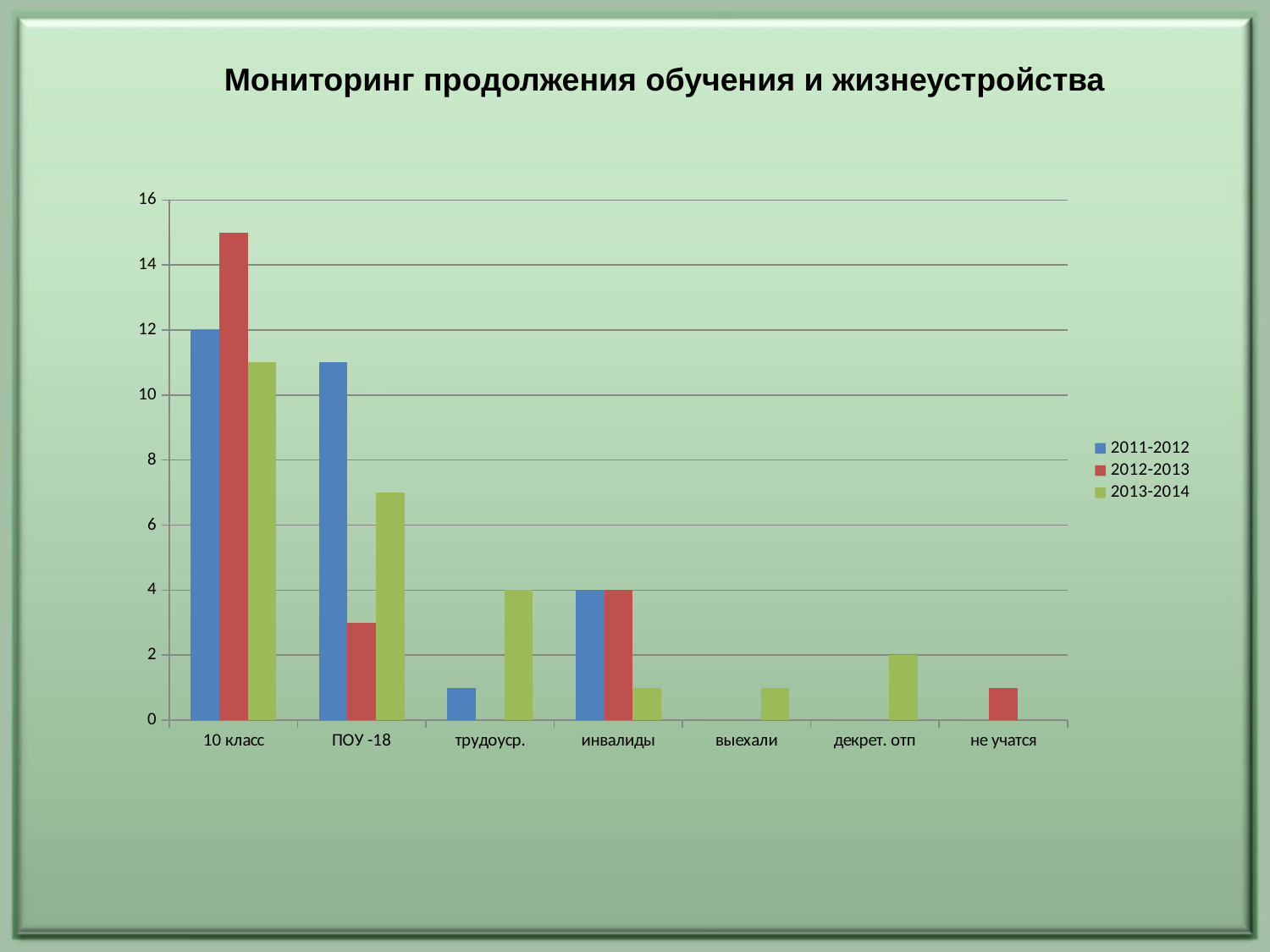
How many categories are shown on the x axis? 7 What is the value for 10 класс in the 2011-2012 series? 12 Which category has the highest value in the 2012-2013 series? 10 класс What kind of chart is shown on the slide? bar chart What is the value for инвалиды in the 2011-2012 series? 4 Which is larger for ПОУ -18: the 2011-2012 value or the 2013-2014 value? 2011-2012 Is the value for ПОУ -18 in the 2012-2013 series greater or less than 4? less Is the value for 10 класс in the 2012-2013 series greater or less than 14? greater How many series does the legend list? 3 What is the value for трудоуср. in the 2013-2014 series? 4 What is the value for декрет. отп in the 2013-2014 series? 2 What is the title of the chart? Мониторинг продолжения обучения и жизнеустройства